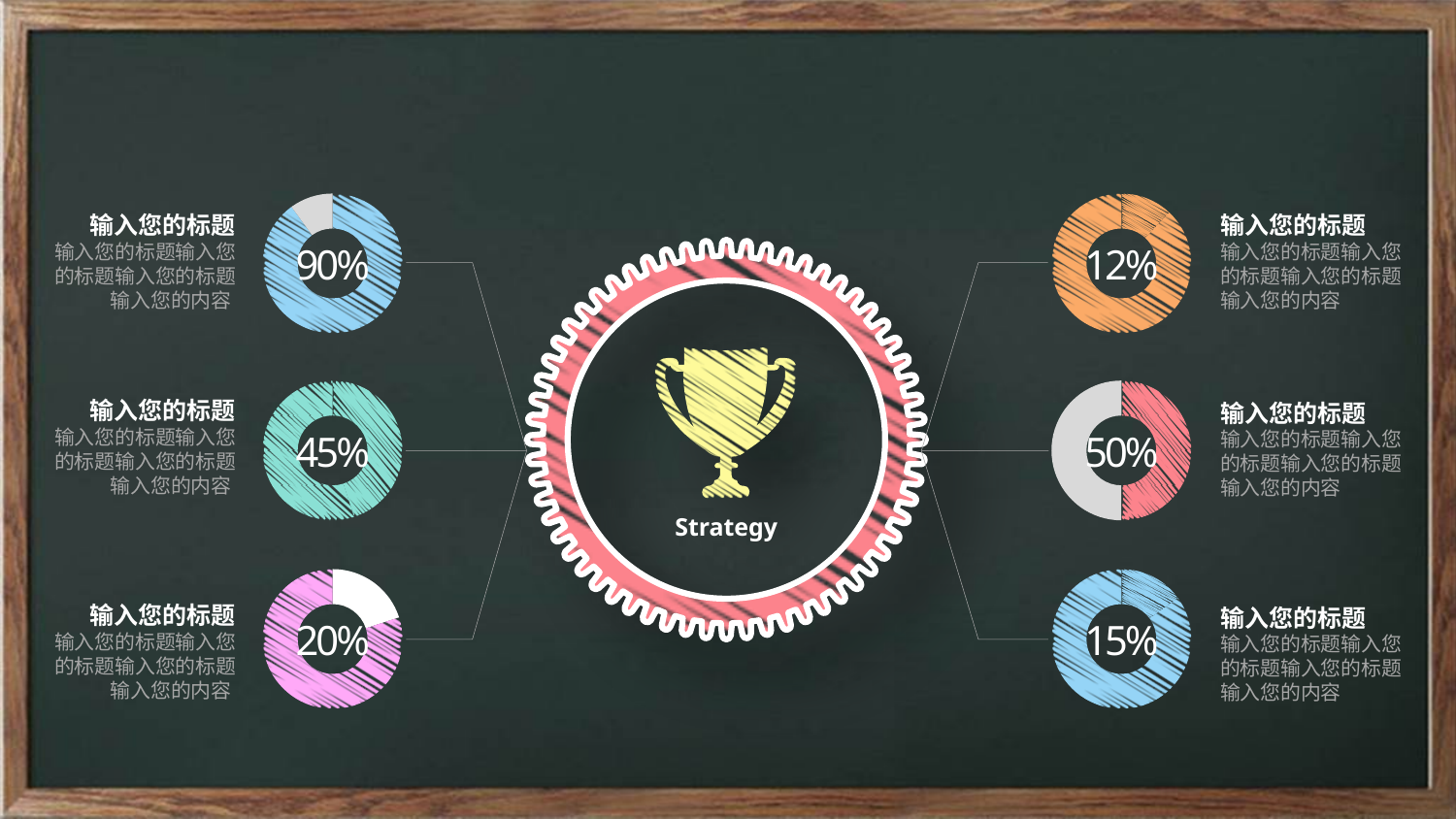
What value is printed in the centre of the middle-left donut chart? 45% What word is written beneath the trophy icon in the central gear shape? Strategy What value is printed in the centre of the bottom-right donut chart? 15% What value is printed in the centre of the top-right donut chart? 12% Which of the six donut charts shows the lowest percentage? The top-right chart (12%) Which is larger, the percentage in the middle-right donut chart or the percentage in the bottom-right donut chart? The middle-right chart (50%) What value is printed in the centre of the top-left donut chart? 90% Which of the six donut charts shows the highest percentage? The top-left chart (90%) What value is printed in the centre of the middle-right donut chart? 50% What value is printed in the centre of the bottom-left donut chart? 20% How many donut charts are shown on the slide? 6 What is the difference between the percentage in the top-left donut chart and the percentage in the middle-left donut chart? 45%